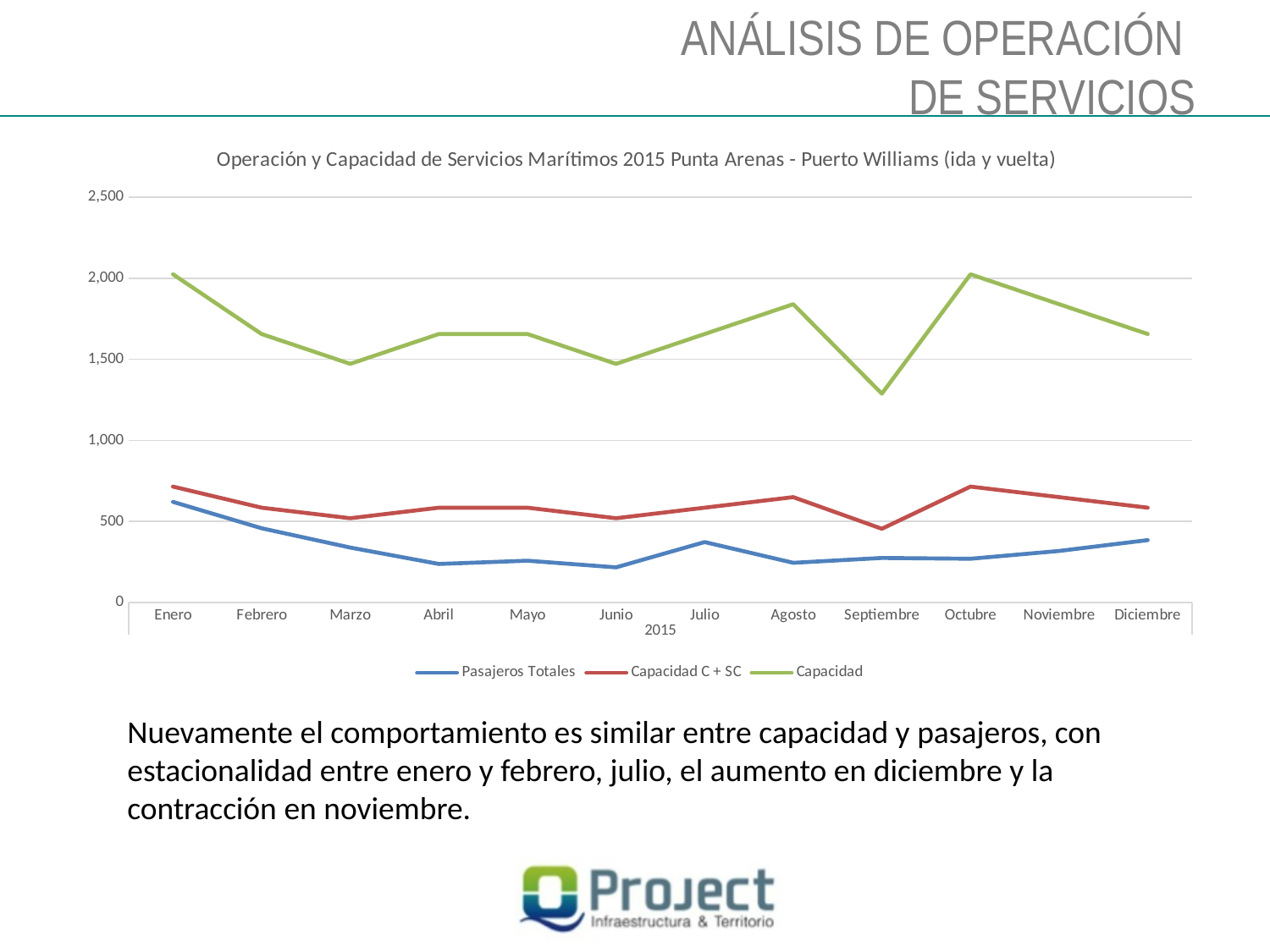
How many series does the legend list? 3 Which is larger, Capacidad in Agosto or Capacidad in Septiembre? Agosto Which series is drawn in green? Capacidad Is the value of Pasajeros Totales in Junio greater or less than 500? less In which month is the Capacidad C + SC series at its lowest? Septiembre How many months are plotted along the x axis? 12 In which month is the Pasajeros Totales series at its highest? Enero What is the title of the chart? Operación y Capacidad de Servicios Marítimos 2015 Punta Arenas - Puerto Williams (ida y vuelta) What kind of chart is shown on the slide? Line chart In which month is the Capacidad series at its lowest? Septiembre Is the value of Capacidad in Septiembre greater or less than 1,500? less Does the Pasajeros Totales series rise or fall from Enero to Junio? Fall